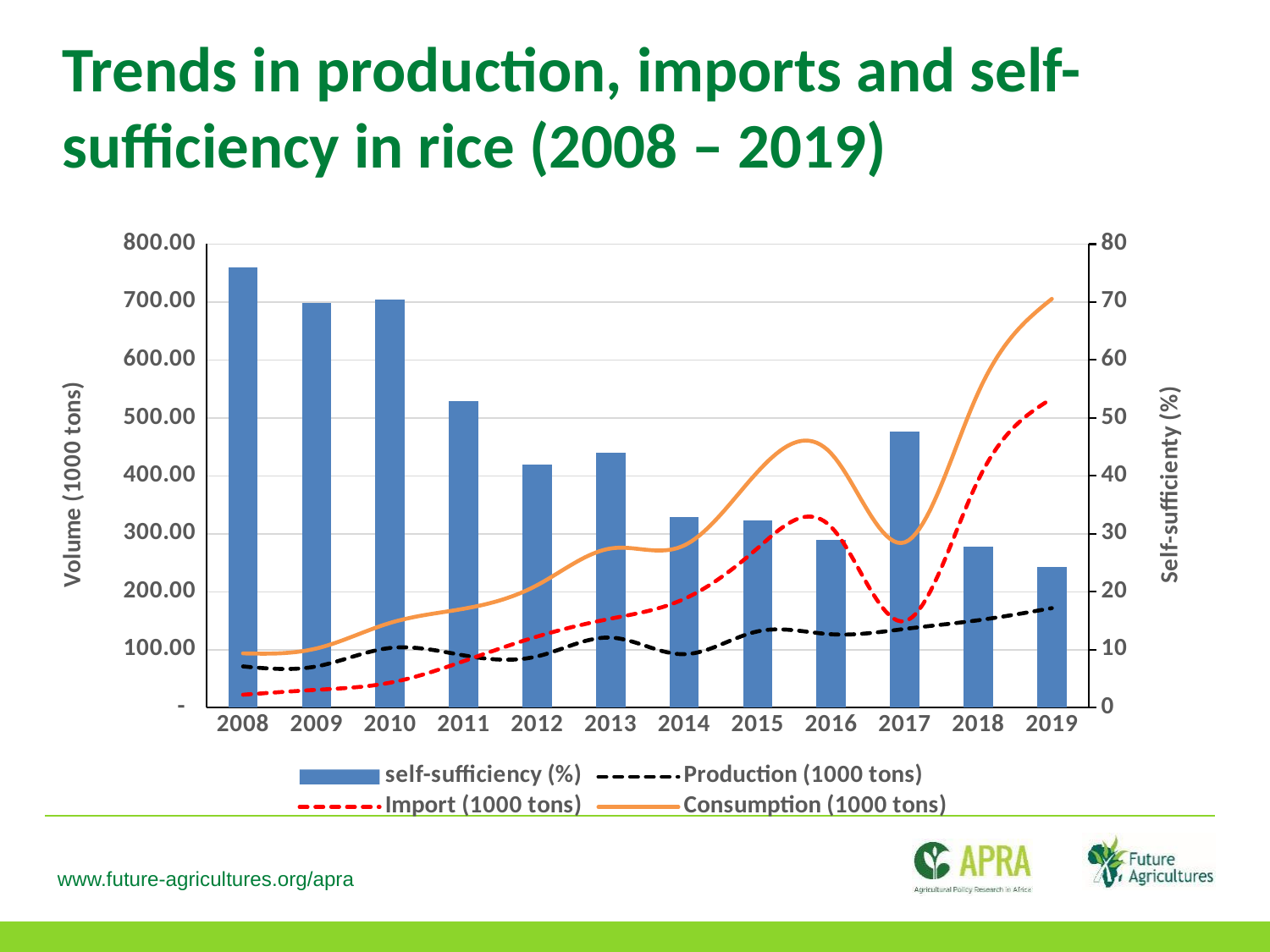
Does the Import (1000 tons) line generally rise or fall from 2008 to 2019? Rise Is the self-sufficiency (%) value for 2019 greater or less than 30? less Is the self-sufficiency (%) value for 2008 greater or less than 70? greater Is the Production (1000 tons) value for 2019 greater or less than 200? less What is the label of the right-hand vertical axis? Self-sufficiency (%) How many years are shown on the x axis? 12 In which year is the self-sufficiency (%) bar the highest? 2008 What kind of chart is shown on the slide? A combination bar and line chart In which year is the self-sufficiency (%) bar the lowest? 2019 How many series does the legend list? 4 Which is larger in 2019, Consumption (1000 tons) or Production (1000 tons)? Consumption (1000 tons)